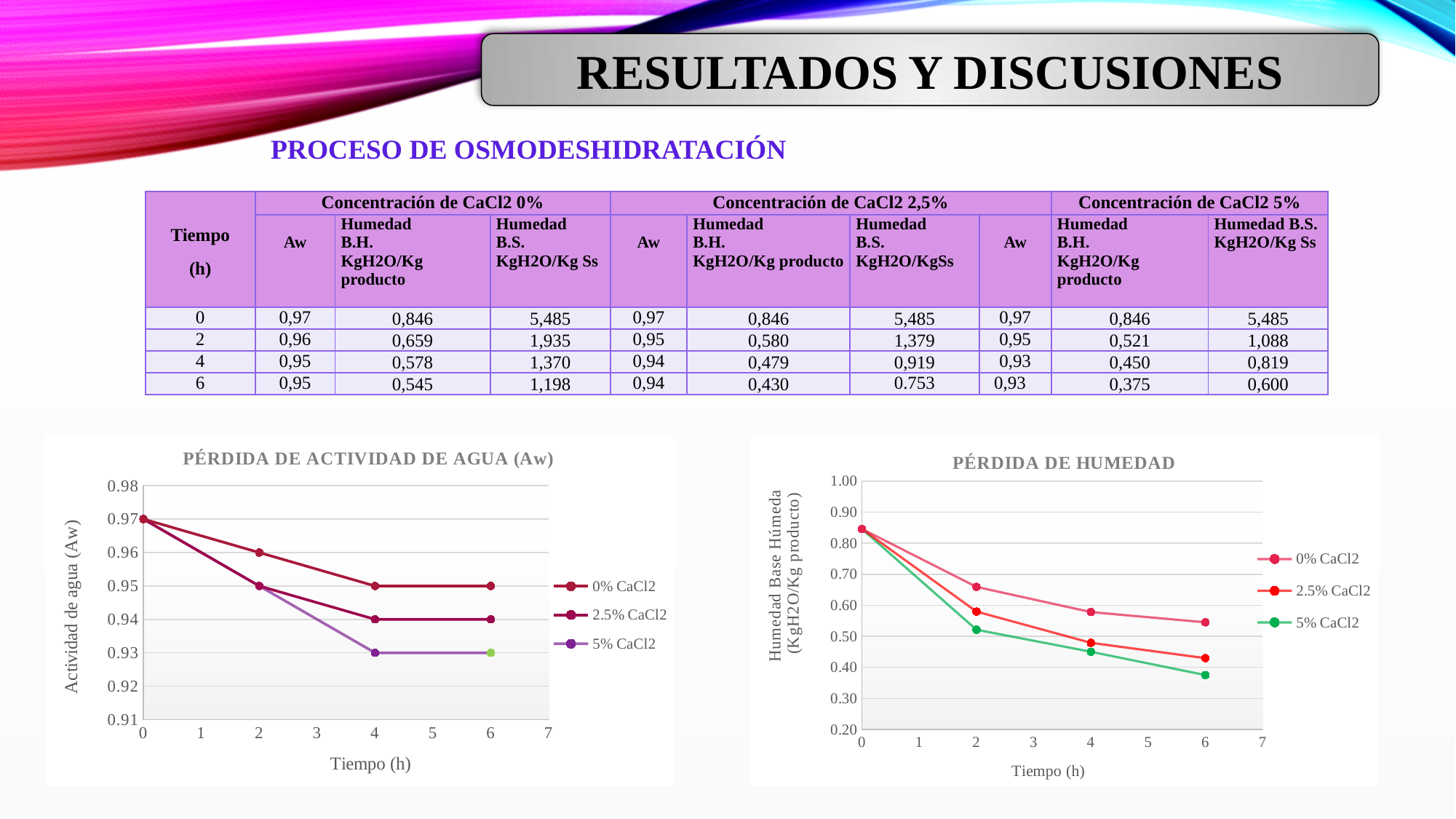
How many data points does each series have in the 'PÉRDIDA DE ACTIVIDAD DE AGUA (Aw)' chart? 4 In the 'PÉRDIDA DE HUMEDAD' chart, is the value for 0% CaCl2 at 2 h greater or less than 0.60? greater In the 'PÉRDIDA DE ACTIVIDAD DE AGUA (Aw)' chart, which series has the lowest Aw at 6 h? 5% CaCl2 In the 'PÉRDIDA DE ACTIVIDAD DE AGUA (Aw)' chart, what is the difference between the Aw of 0% CaCl2 and 5% CaCl2 at 6 h? 0.02 In the 'PÉRDIDA DE HUMEDAD' chart, which series has the higher value at 4 h, 0% CaCl2 or 5% CaCl2? 0% CaCl2 In the 'PÉRDIDA DE ACTIVIDAD DE AGUA (Aw)' chart, what is the Aw value for 5% CaCl2 at 4 h? 0.93 In the 'PÉRDIDA DE ACTIVIDAD DE AGUA (Aw)' chart, what is the Aw value for 0% CaCl2 at 6 h? 0.95 In the 'PÉRDIDA DE ACTIVIDAD DE AGUA (Aw)' chart, does the Aw for 2.5% CaCl2 rise or fall from 0 h to 6 h? fall In the 'PÉRDIDA DE HUMEDAD' chart, is the value for 5% CaCl2 at 6 h greater or less than 0.40? less How many series does the legend of the 'PÉRDIDA DE ACTIVIDAD DE AGUA (Aw)' chart list? 3 What is the x-axis title of the 'PÉRDIDA DE HUMEDAD' chart? Tiempo (h) What kind of chart is the 'PÉRDIDA DE ACTIVIDAD DE AGUA (Aw)' chart? line chart